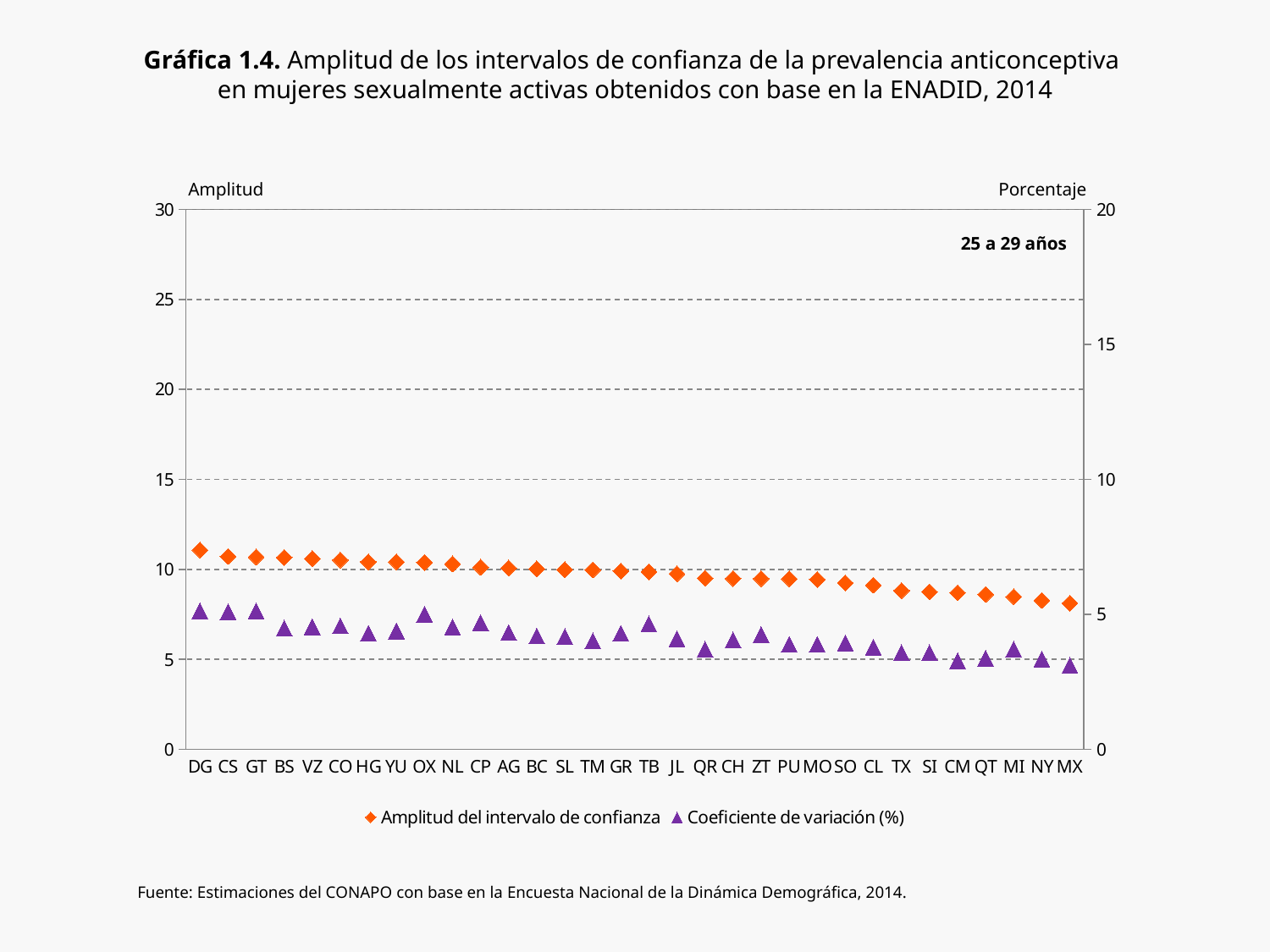
Which category has the highest value for Amplitud del intervalo de confianza? DG Is the Amplitud del intervalo de confianza value for DG greater or less than 10? greater What is the title of the right-hand vertical axis? Porcentaje Which is larger, the Amplitud del intervalo de confianza for DG or for MX? DG Is the Coeficiente de variación (%) value for MX greater or less than 5 on the right axis? less Is the Amplitud del intervalo de confianza value for MX greater or less than 10? less Do the Amplitud del intervalo de confianza values rise or fall from left to right along the x axis? fall Which is larger, the Coeficiente de variación (%) for DG or for MX? DG How many categories (state abbreviations) are shown on the x axis? 32 Which age group is indicated in the label inside the plot area? 25 a 29 años How many series does the legend list? 2 What kind of chart is shown on the slide? Scatter chart